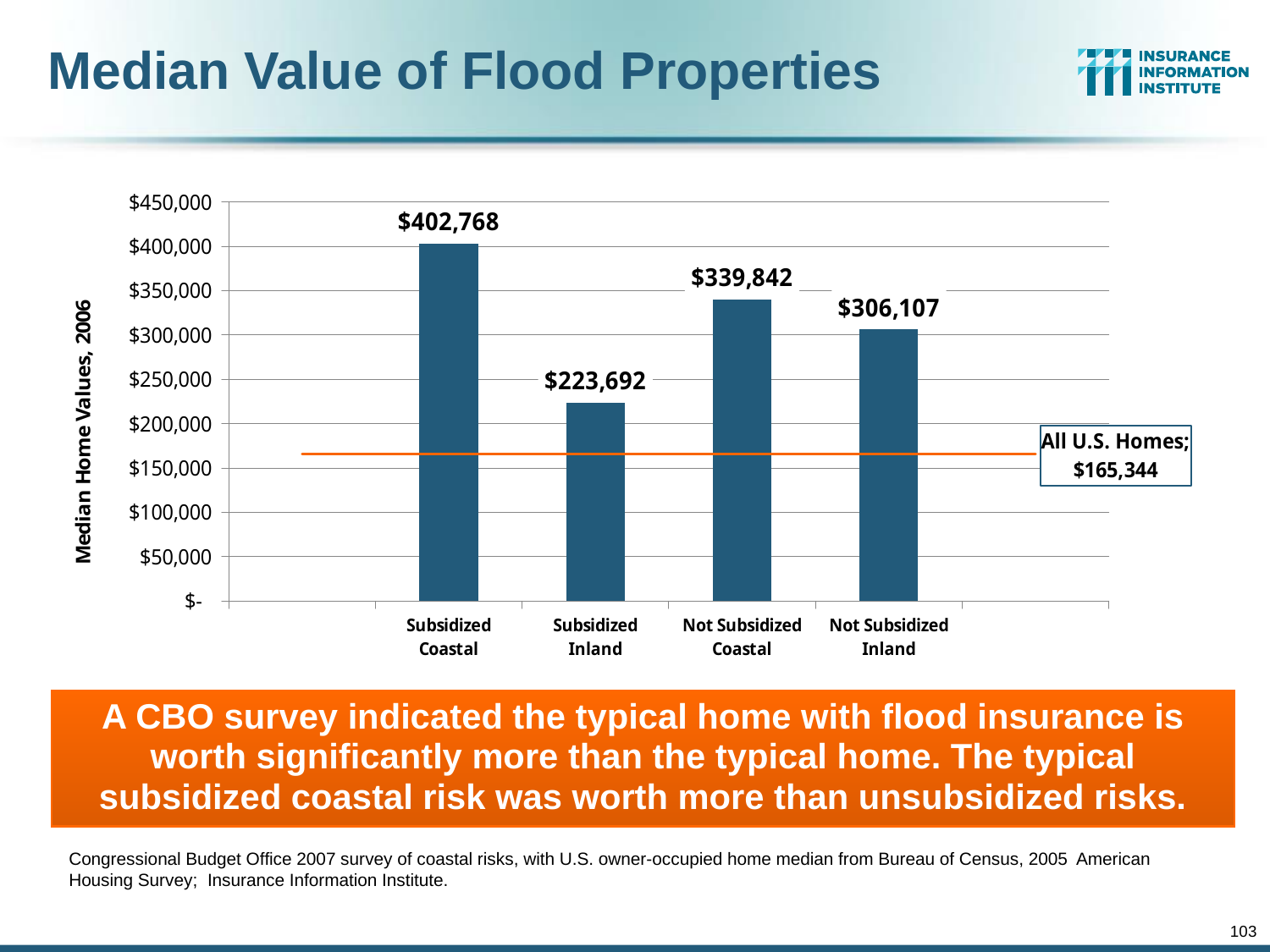
Which category has the highest median home value? Subsidized Coastal What is the difference between the median values for Not Subsidized Coastal and Not Subsidized Inland properties? $33,735 What is the median home value for Not Subsidized Inland properties? $306,107 What is the median home value for Subsidized Coastal properties? $402,768 Which has a larger median home value, Not Subsidized Coastal or Not Subsidized Inland? Not Subsidized Coastal What median value is shown for All U.S. Homes by the horizontal line? $165,344 What is the difference between the median values for Subsidized Coastal and Subsidized Inland properties? $179,076 Which category has the lowest median home value among the four bars? Subsidized Inland What is the median home value for Subsidized Inland properties? $223,692 What is the median home value for Not Subsidized Coastal properties? $339,842 What type of chart is used to show the median value of flood properties? Bar chart How many categories of flood properties are shown as bars in the chart? 4